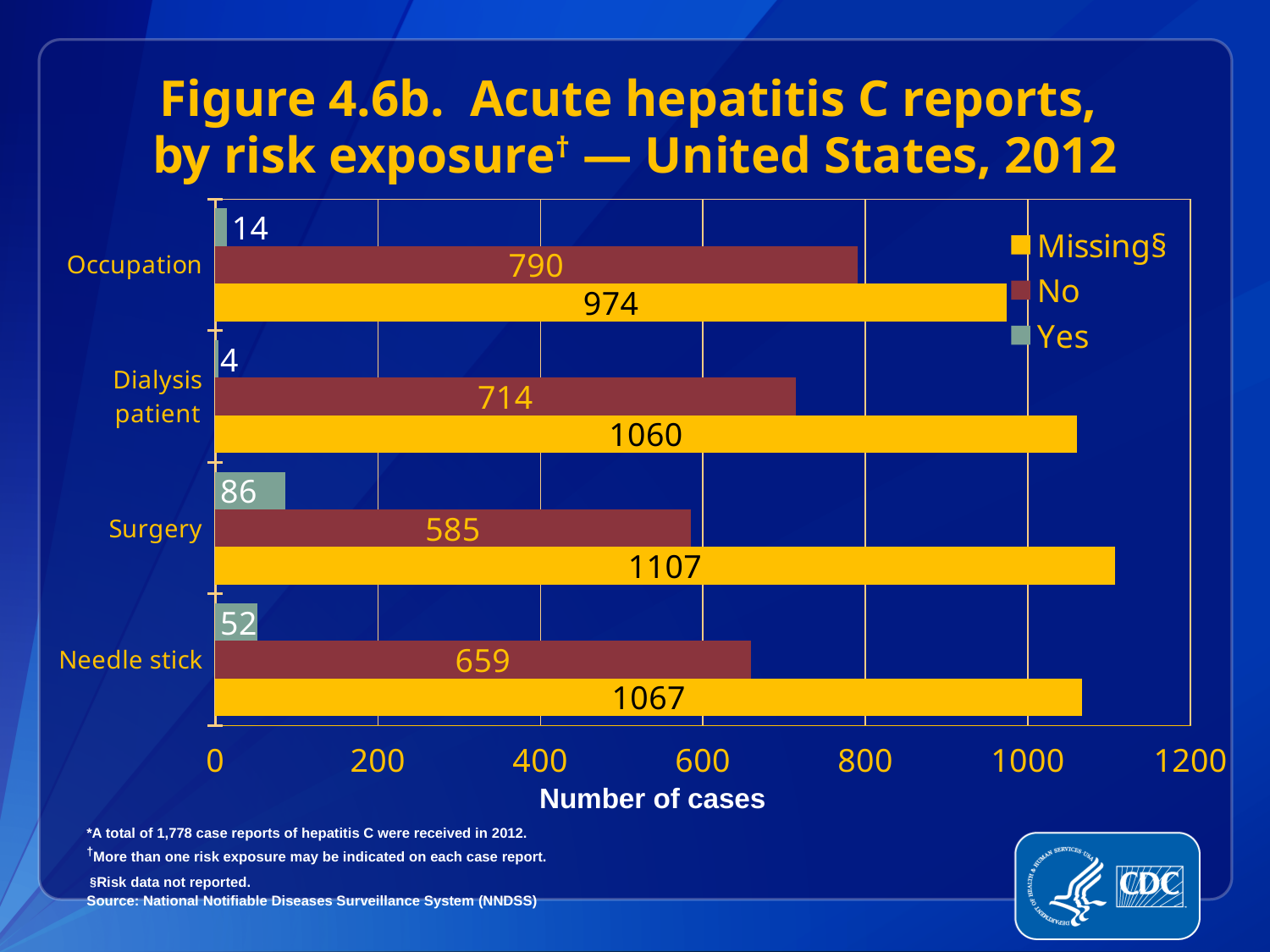
How many series does the legend list? 3 What is the difference between the 'No' values for Occupation and Surgery? 205 Is the 'No' value for Dialysis patient greater or less than 800? less What is the number of cases with 'No' for Needle stick? 659 What is the number of cases with 'Yes' for Surgery? 86 Which risk exposure category has the lowest 'Yes' value? Dialysis patient How many risk exposure categories are shown on the chart? 4 Which is larger, the 'Yes' value for Needle stick or the 'Yes' value for Occupation? Needle stick Which risk exposure category has the highest 'Missing' value? Surgery What is the number of cases with 'Missing' for Dialysis patient? 1060 What is the label of the x axis? Number of cases What kind of chart is shown on the slide? bar chart